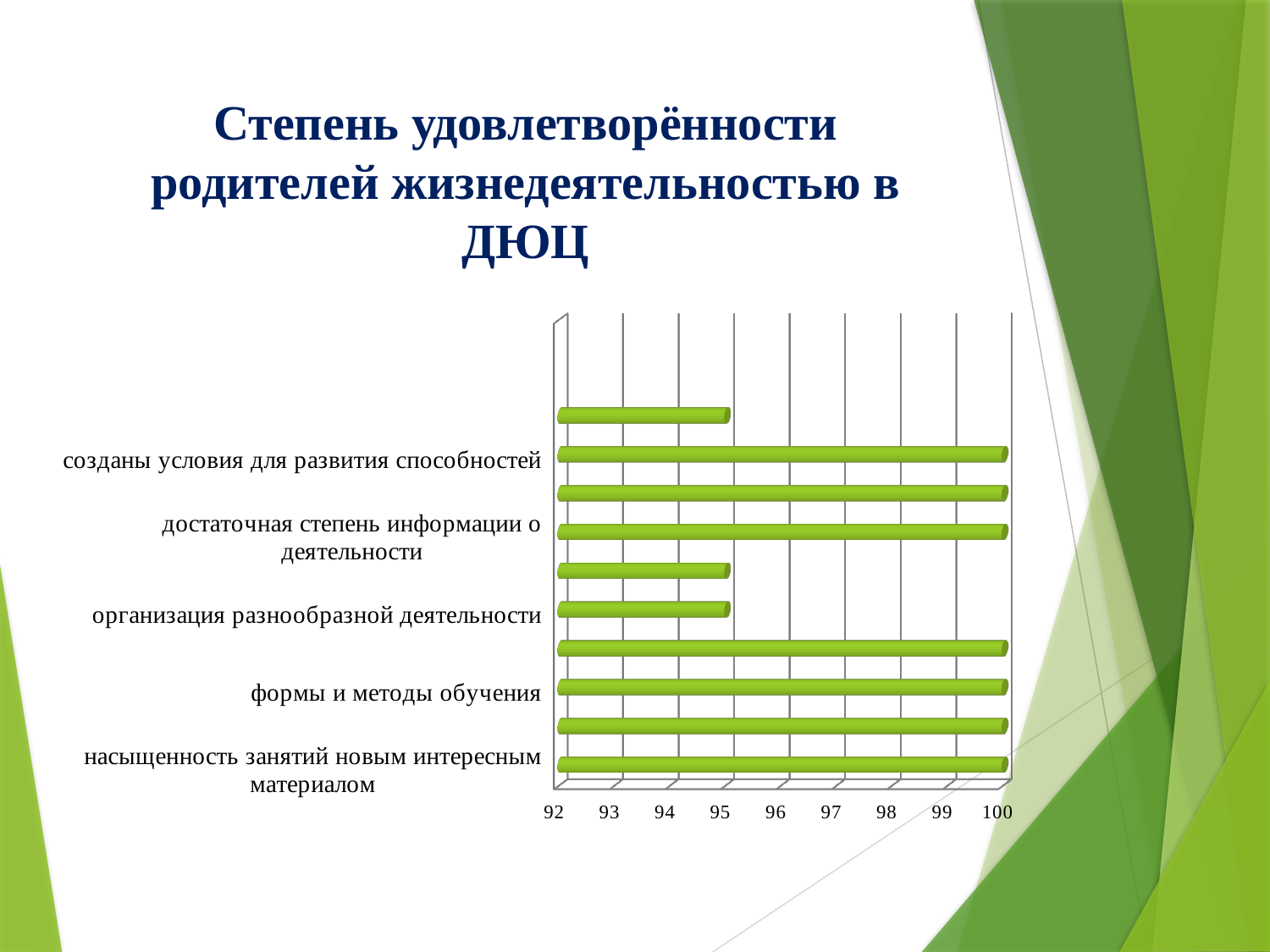
How many bars are plotted in the chart? 10 What kind of chart is shown on the slide? bar chart Is the value for "насыщенность занятий новым интересным материалом" greater or less than 97? greater Among the labelled categories, which one has the lowest value? организация разнообразной деятельности Is the value for "достаточная степень информации о деятельности" greater or less than 96? greater What are the minimum and maximum values shown on the horizontal axis? 92 and 100 Is the value for "организация разнообразной деятельности" greater or less than 97? less What is the title of the slide's chart? Степень удовлетворённости родителей жизнедеятельностью в ДЮЦ What is the value for "формы и методы обучения"? 100 Which is larger: the value for "формы и методы обучения" or the value for "организация разнообразной деятельности"? формы и методы обучения